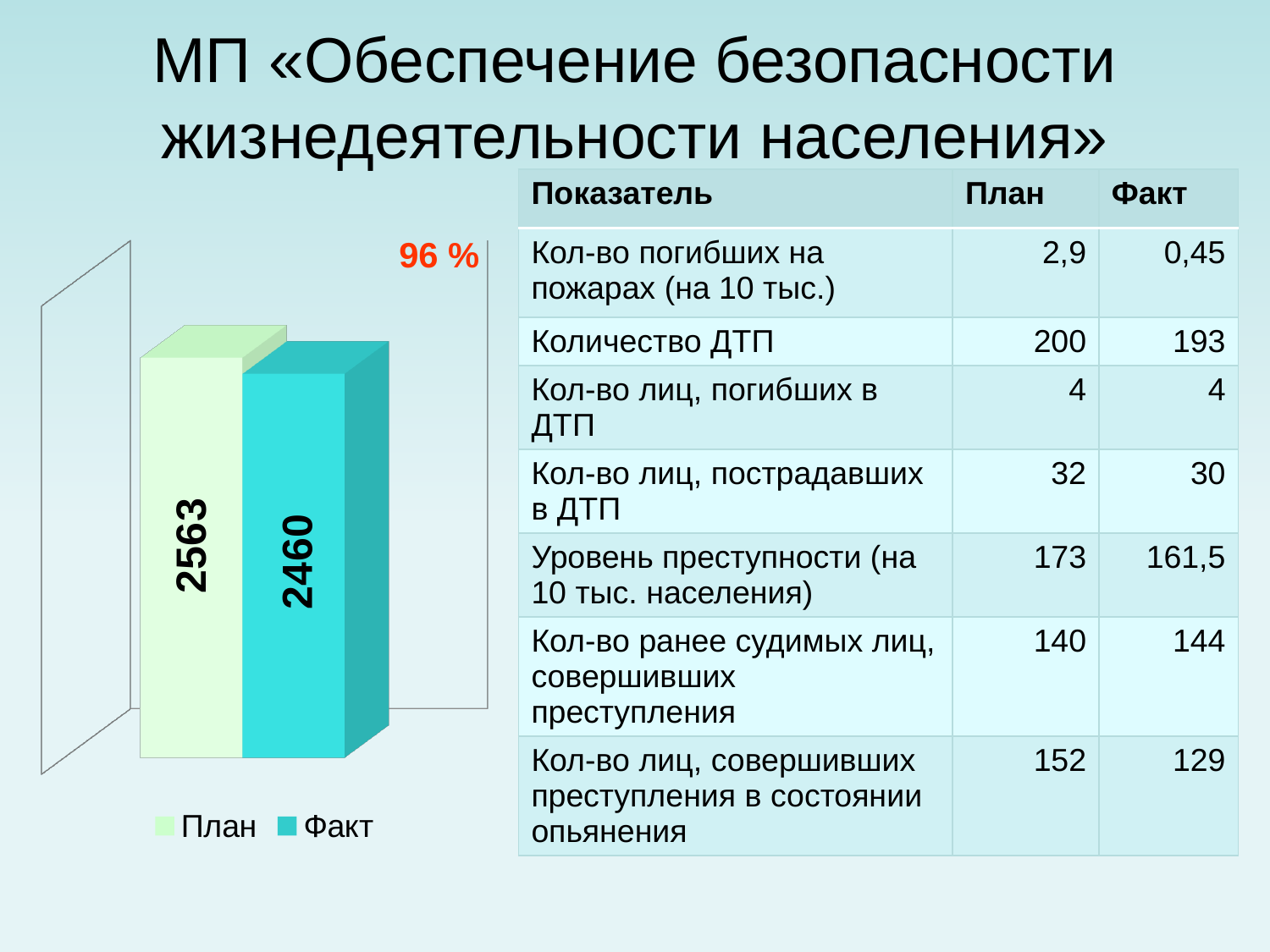
What is the value of the План bar in the chart? 2563 How many series does the chart legend list? 2 Which series has the lowest value in the chart? Факт Which bar in the chart is higher, План or Факт? План What kind of chart is shown on the left of the slide? bar chart What is the value of the Факт bar in the chart? 2460 What is the difference between the План and Факт values in the chart? 103 How many bars are plotted in the chart? 2 What colour is the Факт bar in the chart? teal What percentage is printed above the chart? 96 %